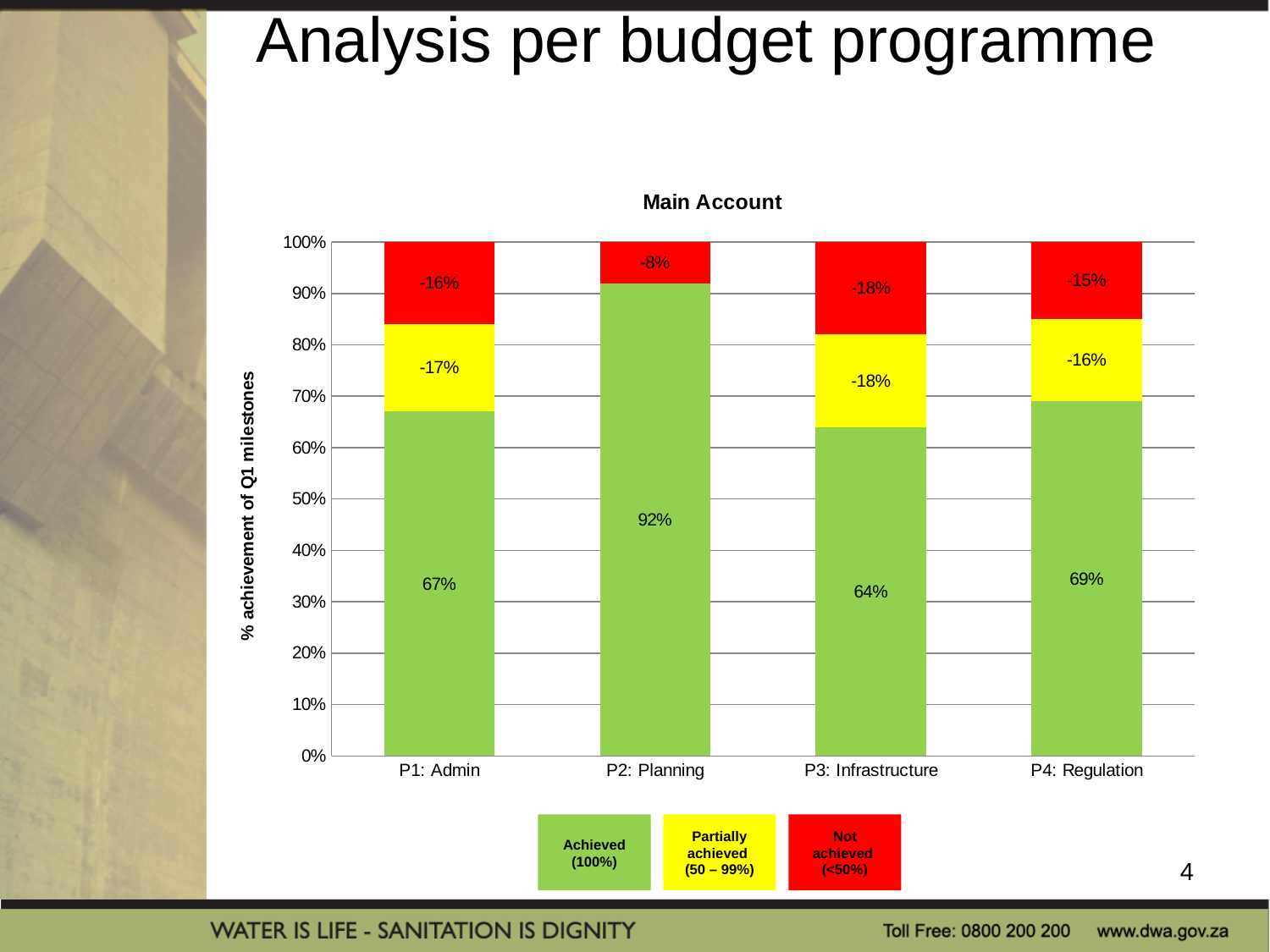
How many series does the legend list? 3 How many budget programmes are shown on the x axis? 4 Which budget programme has the lowest Achieved (100%) value? P3: Infrastructure What is the Achieved (100%) value for P3: Infrastructure? 64% What label is shown on the Not achieved (<50%) segment for P1: Admin? -16% Which budget programme has the highest Achieved (100%) value? P2: Planning What label is shown on the Partially achieved (50 – 99%) segment for P4: Regulation? -16% Which has a larger Achieved (100%) value, P4: Regulation or P1: Admin? P4: Regulation What kind of chart is shown on the slide? Stacked bar chart What is the difference between the Achieved (100%) values for P2: Planning and P1: Admin? 25 percentage points What is the Achieved (100%) value for P2: Planning? 92% What is the title of the chart? Main Account